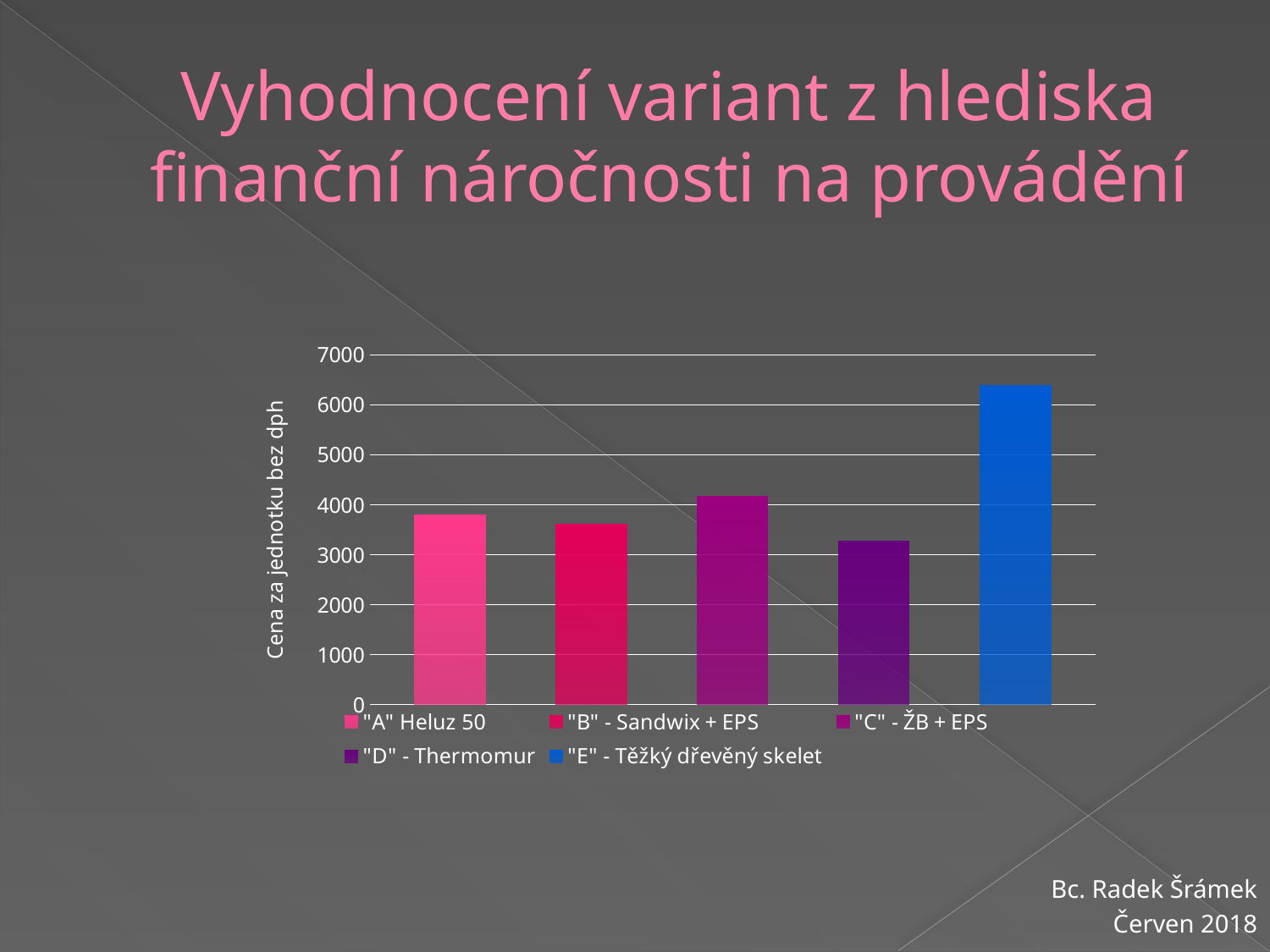
Which variant has the highest value in the chart? "E" - Těžký dřevěný skelet Is the value for "D" - Thermomur greater or less than 4000? less What is the title of the vertical axis of the chart? Cena za jednotku bez dph What kind of chart is shown on the slide? bar chart Is the value for "A" Heluz 50 greater or less than 3000? greater Which is larger, the value for "C" - ŽB + EPS or the value for "B" - Sandwix + EPS? "C" - ŽB + EPS How many entries does the legend list? 5 Which is larger, the value for "E" - Těžký dřevěný skelet or the value for "A" Heluz 50? "E" - Těžký dřevěný skelet Is the value for "C" - ŽB + EPS greater or less than 4000? greater Which variant has the lowest value in the chart? "D" - Thermomur How many bars are plotted in the chart? 5